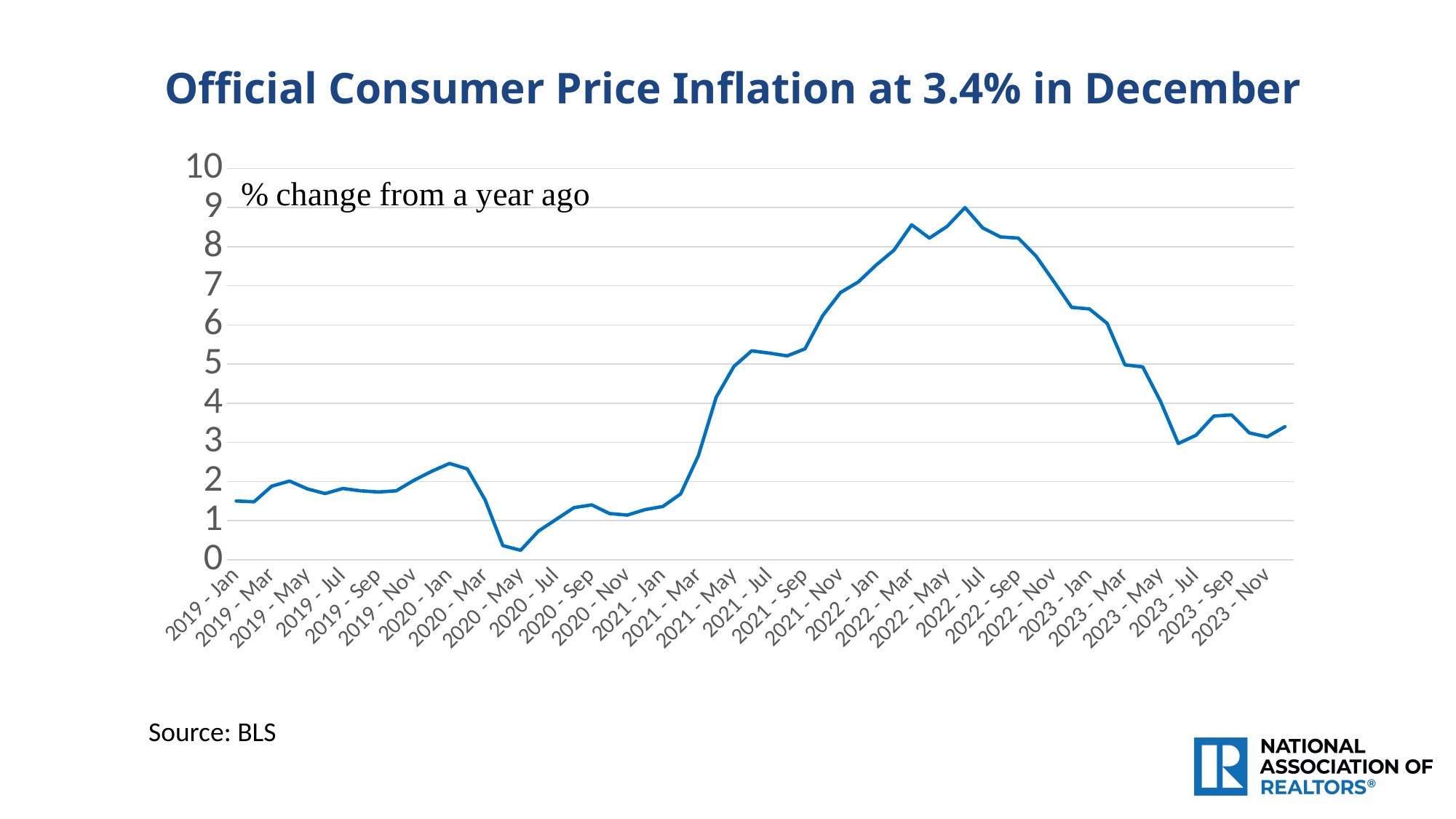
According to the slide, what was consumer price inflation in December 2023? 3.4% What does the label inside the plot area say the values represent? % change from a year ago In which year does the line reach its highest point? 2022 In which year does the line reach its lowest point? 2020 Which is larger, the value for 2020 - May or the value for 2023 - Nov? 2023 - Nov Is the value for 2022 - Sep greater or less than 7? greater Is the value for 2021 - Nov greater or less than 6? greater What kind of chart is shown on the slide? line chart Does the line generally rise or fall between 2021 - Jan and 2022 - May? rise What is the title of the chart? Official Consumer Price Inflation at 3.4% in December Is the value for 2020 - May greater or less than 1? less